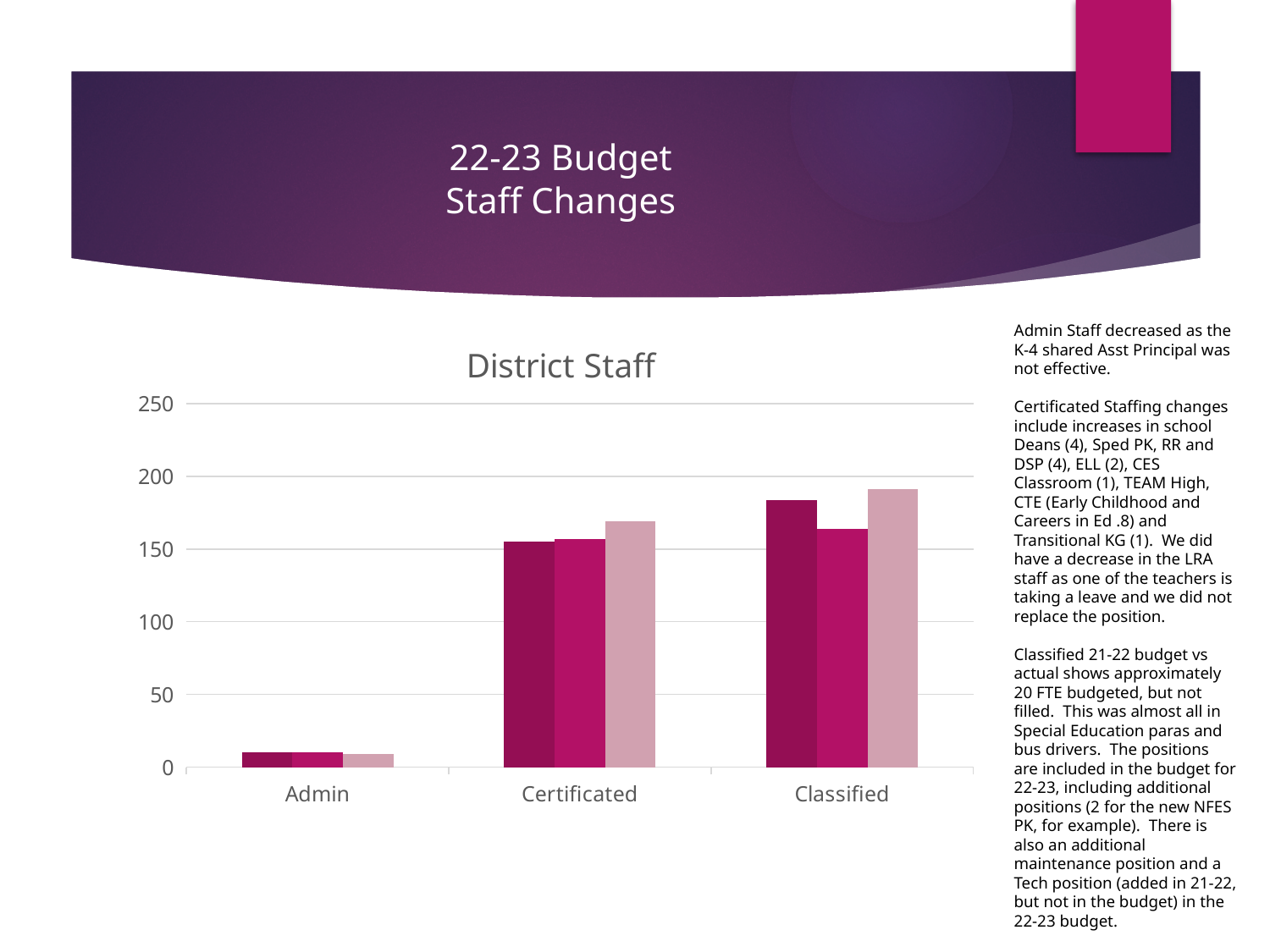
How many categories are shown on the x axis of the "District Staff" chart? 3 What kind of chart is the "District Staff" chart? bar chart Which category has the lowest values in the "District Staff" chart? Admin Is the tallest bar for Certificated greater or less than 200? less Are the bars for Admin greater or less than 50? less Are the bars for Certificated greater or less than 100? greater Which category has larger values, Admin or Certificated? Certificated Which category contains the tallest bar in the "District Staff" chart? Classified What is the title of the chart on the slide? District Staff What is the highest value shown on the y axis of the "District Staff" chart? 250 How many bars are plotted for each category in the "District Staff" chart? 3